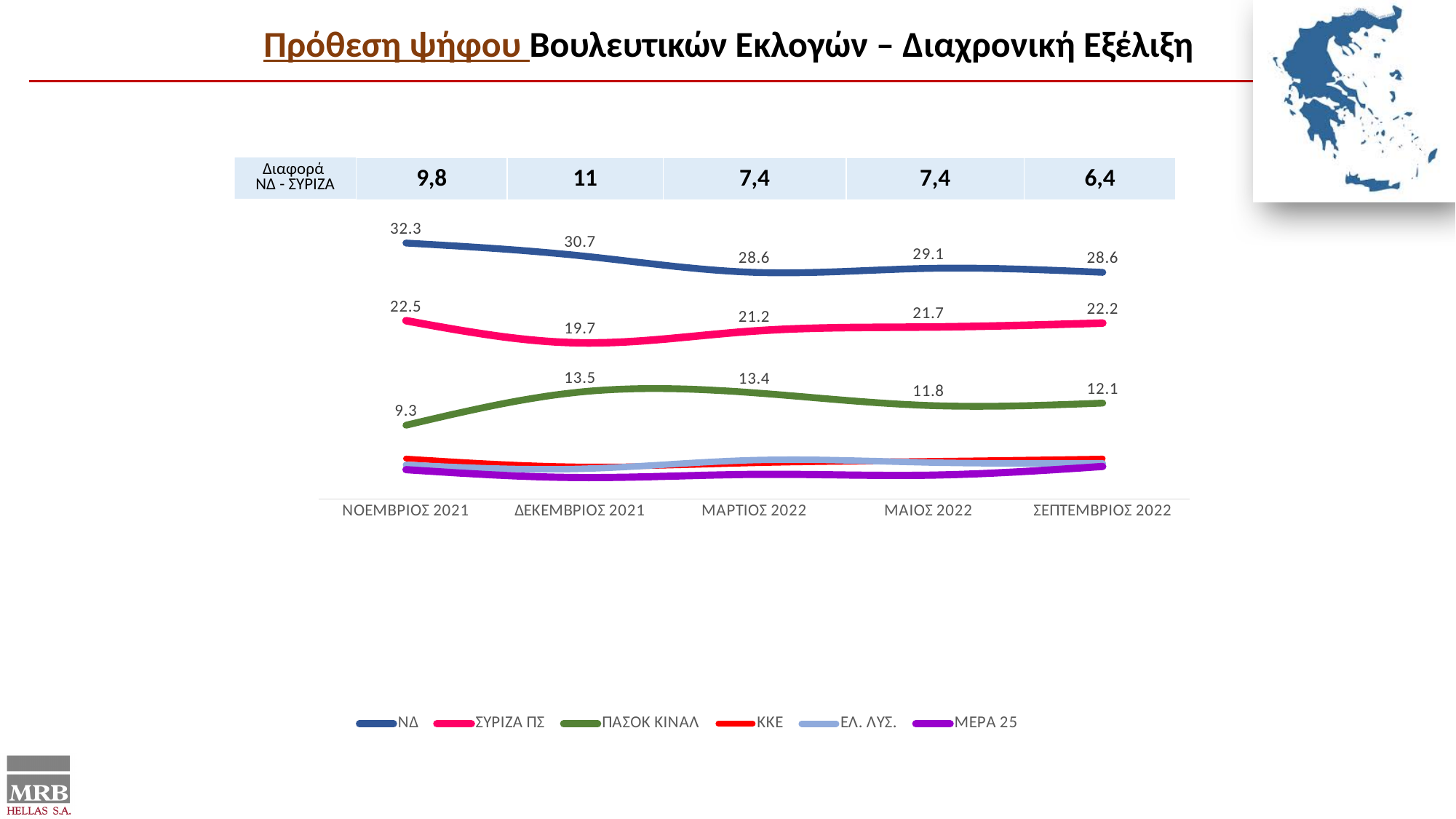
What is the difference between ΝΔ and ΣΥΡΙΖΑ ΠΣ in ΣΕΠΤΕΜΒΡΙΟΣ 2022? 6.4 What kind of chart is shown on the slide? Line chart How many series does the legend list? 6 What is the value for ΝΔ in ΝΟΕΜΒΡΙΟΣ 2021? 32.3 In which period does ΝΔ reach its highest value? ΝΟΕΜΒΡΙΟΣ 2021 Does the value for ΝΔ rise or fall from ΝΟΕΜΒΡΙΟΣ 2021 to ΜΑΡΤΙΟΣ 2022? Fall How many time periods are shown on the x axis? 5 In which period does ΠΑΣΟΚ ΚΙΝΑΛ have its lowest value? ΝΟΕΜΒΡΙΟΣ 2021 What is the value for ΣΥΡΙΖΑ ΠΣ in ΔΕΚΕΜΒΡΙΟΣ 2021? 19.7 What colour is the line for ΠΑΣΟΚ ΚΙΝΑΛ? Green Which is larger in ΜΑΡΤΙΟΣ 2022: ΣΥΡΙΖΑ ΠΣ or ΠΑΣΟΚ ΚΙΝΑΛ? ΣΥΡΙΖΑ ΠΣ What is the value for ΠΑΣΟΚ ΚΙΝΑΛ in ΣΕΠΤΕΜΒΡΙΟΣ 2022? 12.1